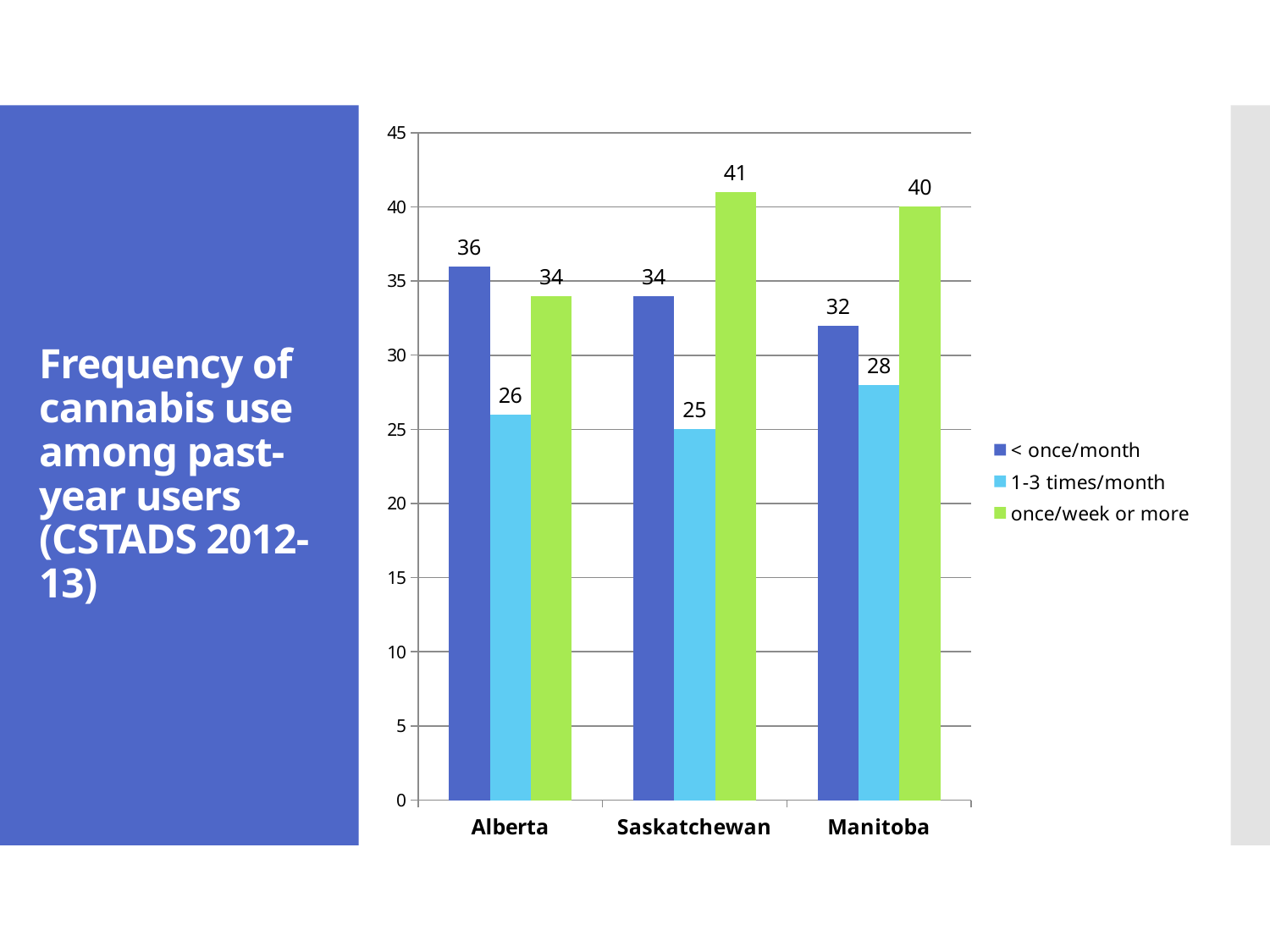
What is the value for '< once/month' in Alberta? 36 Which colour represents the '1-3 times/month' series? Light blue What is the difference between the 'once/week or more' and '1-3 times/month' values in Manitoba? 12 Which province has the highest value for 'once/week or more'? Saskatchewan What is the value for 'once/week or more' in Saskatchewan? 41 What is the value for '1-3 times/month' in Manitoba? 28 Which province has the lowest value for '1-3 times/month'? Saskatchewan What kind of chart is shown on the slide? Bar chart Which is larger in Alberta: '< once/month' or 'once/week or more'? < once/month Is the value for '< once/month' in Manitoba greater or less than 30? greater How many provinces are shown on the x axis? 3 How many series does the legend list? 3